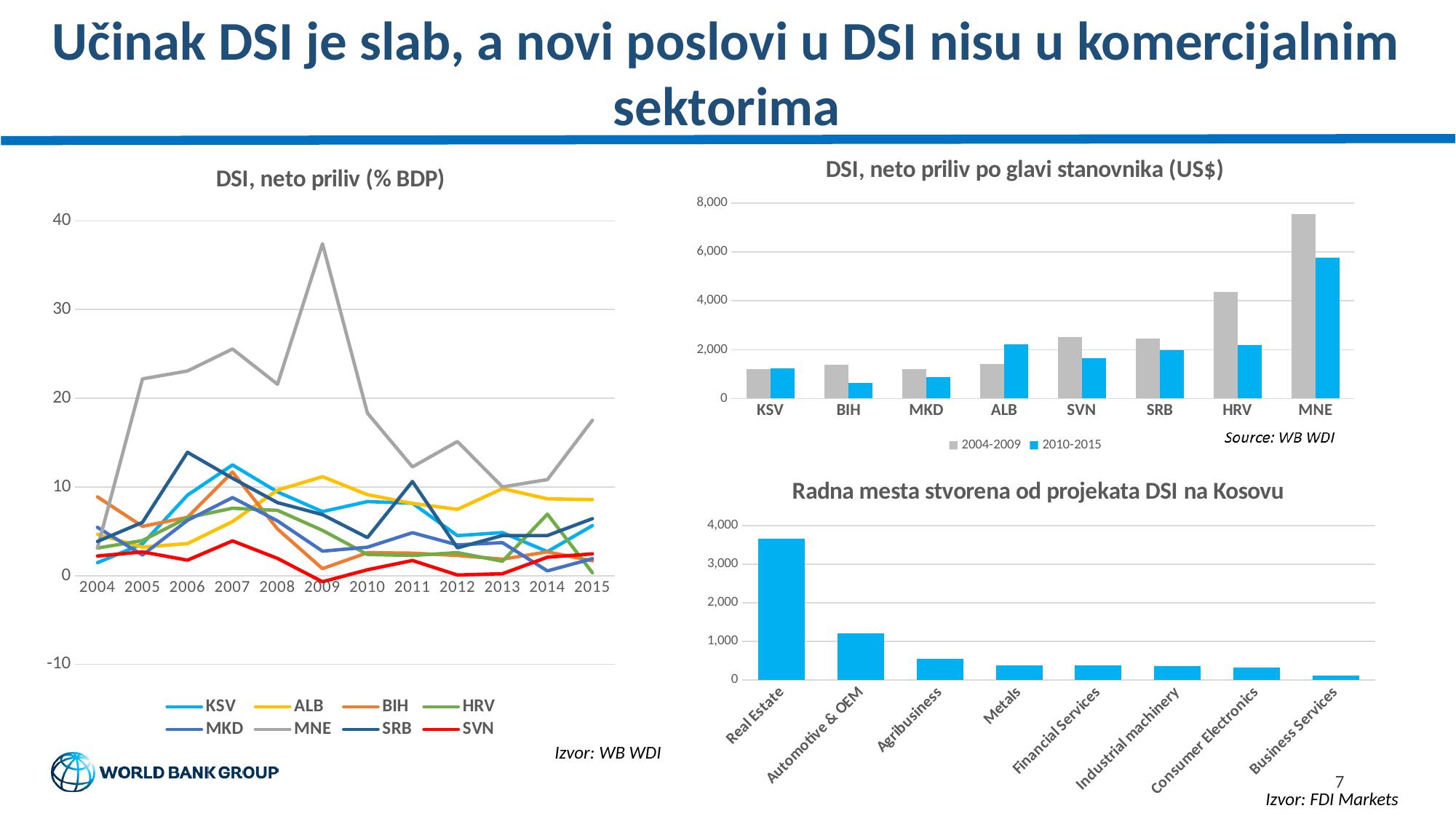
In the 'DSI, neto priliv (% BDP)' chart, is the value for MNE in 2009 greater or less than 30? greater In the 'Radna mesta stvorena od projekata DSI na Kosovu' chart, is the value for Real Estate greater or less than 3,000? greater In the 'DSI, neto priliv po glavi stanovnika (US$)' chart, is the 2010-2015 value for BIH greater or less than 1,000? less In the 'Radna mesta stvorena od projekata DSI na Kosovu' chart, which sector has the highest value? Real Estate How many series does the legend of the 'DSI, neto priliv (% BDP)' chart list? 8 In the 'DSI, neto priliv (% BDP)' chart, how many years are shown on the x axis? 12 How many series does the legend of the 'DSI, neto priliv po glavi stanovnika (US$)' chart list? 2 In the 'DSI, neto priliv po glavi stanovnika (US$)' chart, which is larger for ALB: the 2004-2009 value or the 2010-2015 value? 2010-2015 In the 'DSI, neto priliv (% BDP)' chart, which country has the highest value in 2009? MNE What kind of chart is the 'DSI, neto priliv (% BDP)' chart? line chart In the 'DSI, neto priliv po glavi stanovnika (US$)' chart, which country has the highest 2004-2009 value? MNE